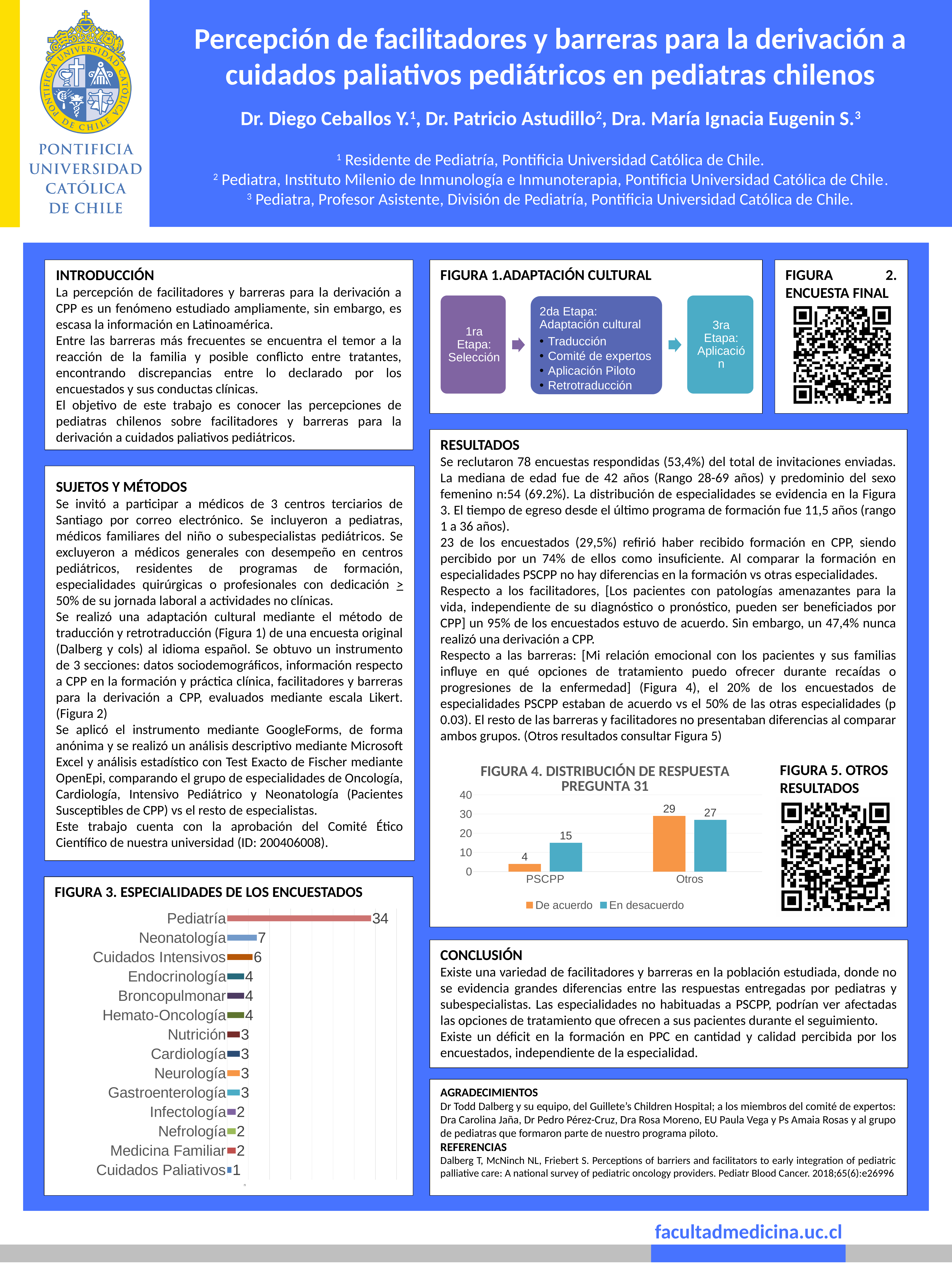
In Figura 3 (Especialidades de los encuestados), what is the value for Neonatología? 7 In Figura 4 (Distribución de respuesta pregunta 31), what is the value for De acuerdo in the PSCPP group? 4 In Figura 4 (Distribución de respuesta pregunta 31), how many series does the legend list? 2 In Figura 3 (Especialidades de los encuestados), how many specialties are listed? 14 In Figura 3 (Especialidades de los encuestados), what is the difference between Pediatría and Cuidados Intensivos? 28 In Figura 4 (Distribución de respuesta pregunta 31), which is larger for the Otros group, De acuerdo or En desacuerdo? De acuerdo In Figura 3 (Especialidades de los encuestados), which specialty has the lowest value? Cuidados Paliativos In Figura 4 (Distribución de respuesta pregunta 31), what is the difference between En desacuerdo and De acuerdo in the PSCPP group? 11 In Figura 3 (Especialidades de los encuestados), what kind of chart is shown? Bar chart In Figura 3 (Especialidades de los encuestados), what is the value for Pediatría? 34 In Figura 4 (Distribución de respuesta pregunta 31), what is the value for En desacuerdo in the Otros group? 27 In Figura 3 (Especialidades de los encuestados), which specialty has the highest value? Pediatría